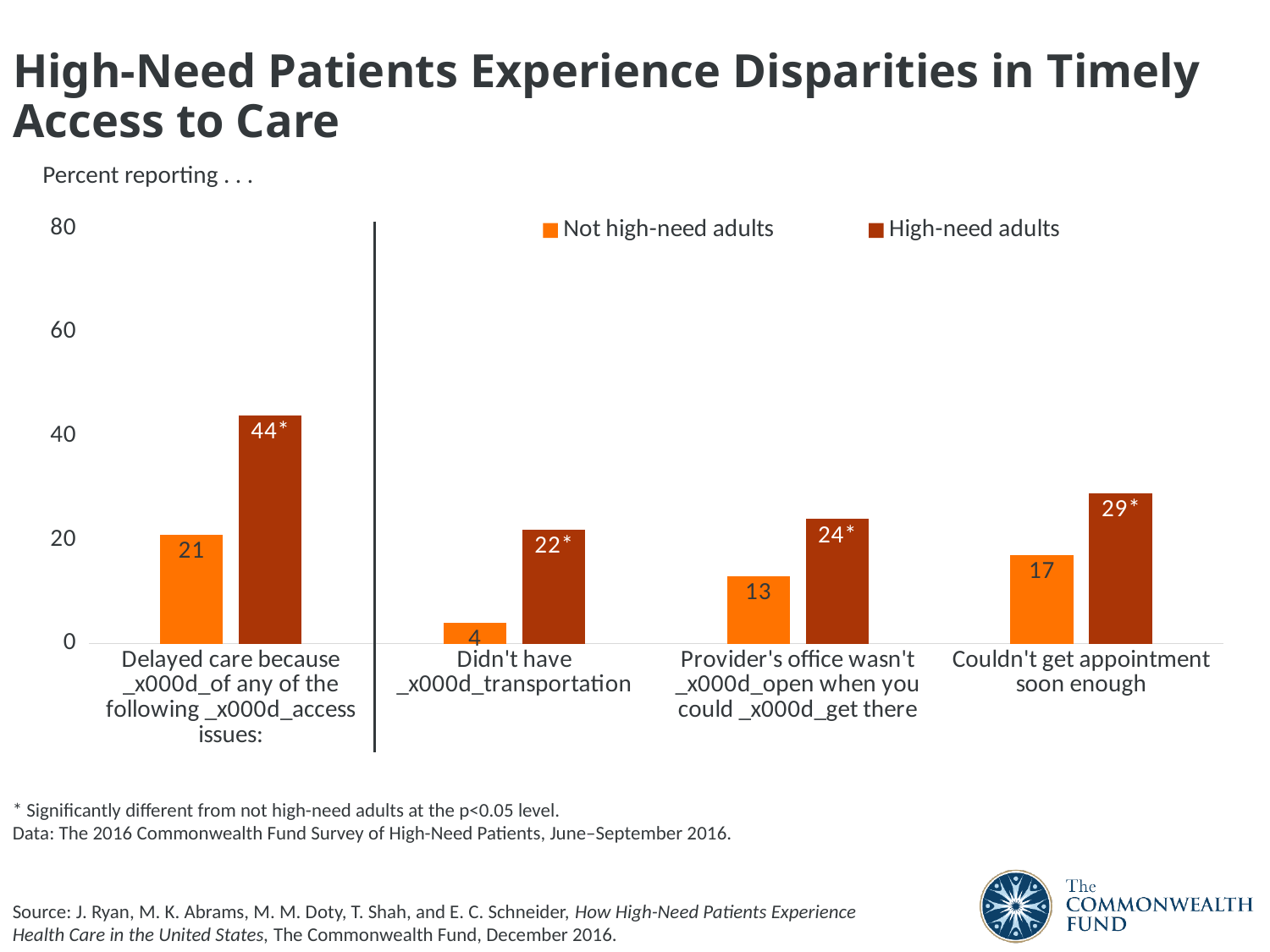
Which access issue has the lowest value for not high-need adults? Didn't have transportation What kind of chart is shown on the slide? Bar chart What is the difference between high-need adults and not high-need adults for delayed care because of any of the following access issues? 23 What percentage of high-need adults reported delayed care because of any of the following access issues? 44* What percentage of high-need adults reported the provider's office wasn't open when they could get there? 24* What percentage of not high-need adults reported they didn't have transportation? 4 How many series does the legend list? 2 What percentage of not high-need adults reported they couldn't get an appointment soon enough? 17 Which group has the larger value for didn't have transportation, not high-need adults or high-need adults? High-need adults How many access issue categories are shown on the chart? 4 Which access issue has the highest value for high-need adults? Delayed care because of any of the following access issues What is the difference between high-need adults and not high-need adults for couldn't get appointment soon enough? 12